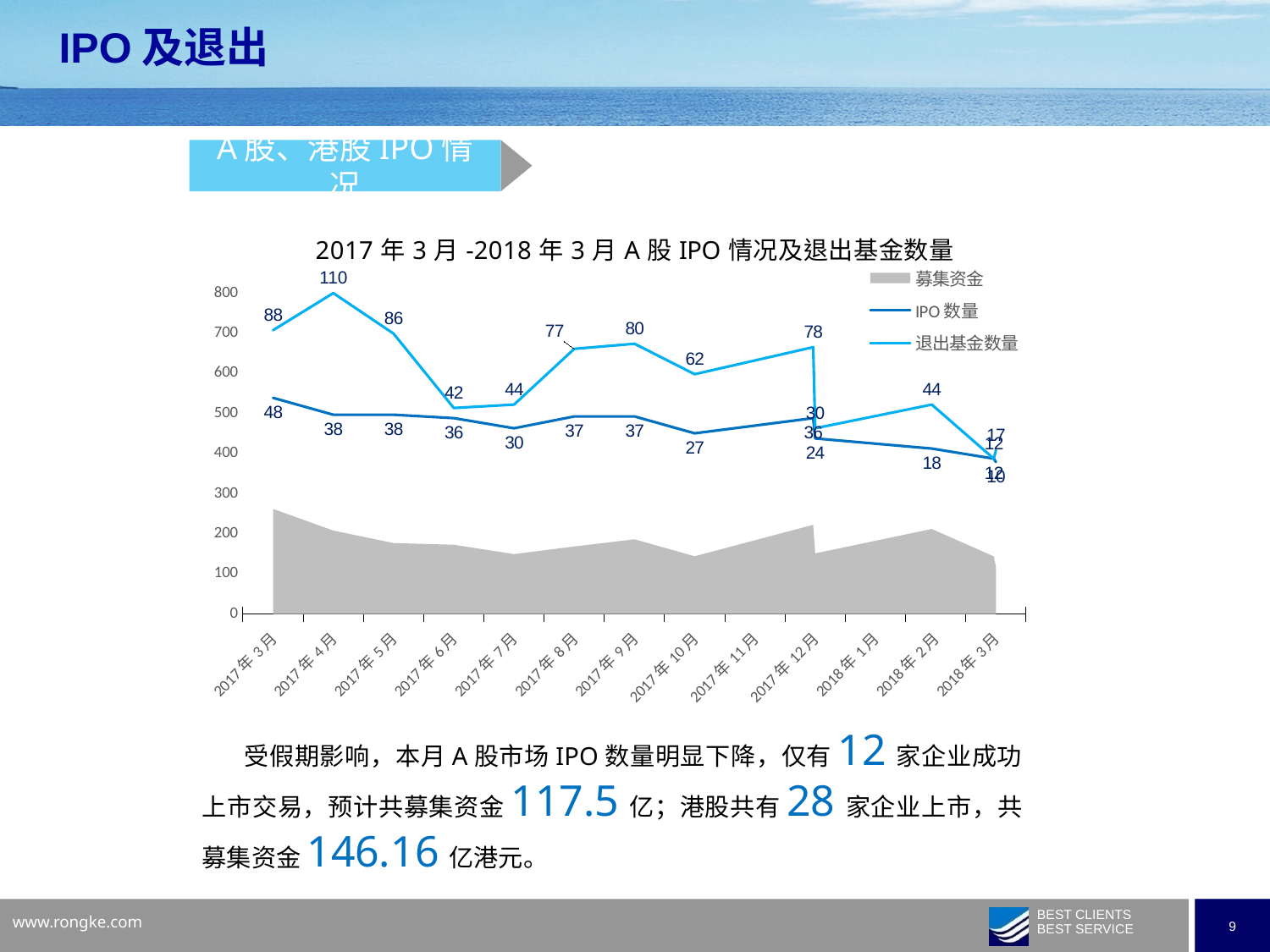
What is the value of 退出基金数量 for 2017年4月? 110 Which is larger, IPO数量 in 2017年3月 or in 2017年4月? 2017年3月 Is the value of 募集资金 for 2017年3月 greater or less than 200? greater How many months are shown on the x axis of the chart? 13 What is the value of IPO数量 for 2017年10月? 27 How many series does the chart legend list? 3 What is the difference between 退出基金数量 in 2017年4月 and 2017年3月? 22 What is the title of the chart? 2017年3月-2018年3月A股IPO情况及退出基金数量 In which month is IPO数量 lowest? 2018年3月 What is the value of IPO数量 for 2017年3月? 48 In which month is 退出基金数量 highest? 2017年4月